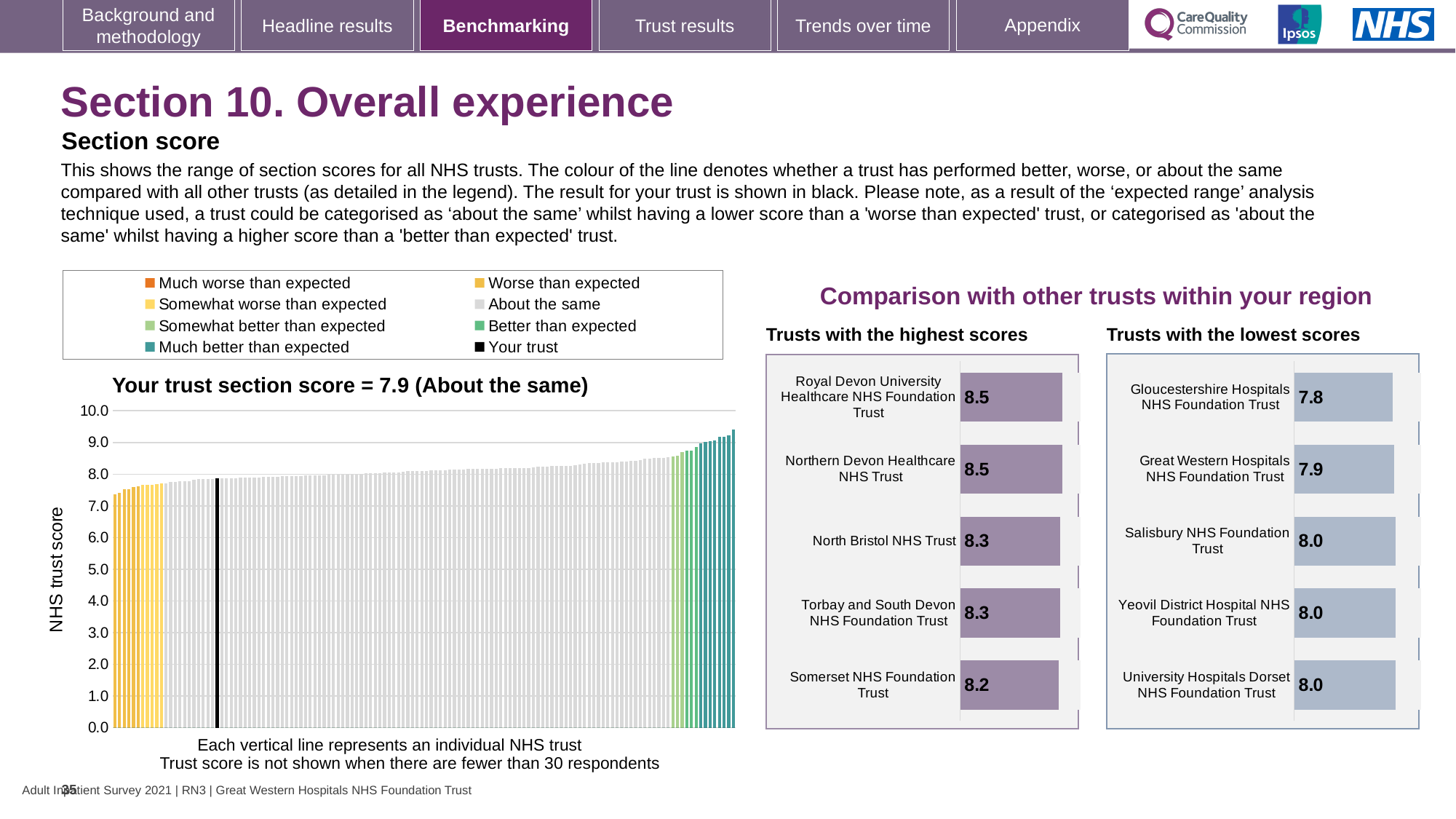
What kind of chart is the 'Your trust section score' chart? bar chart How many trusts are shown in the 'Trusts with the lowest scores' chart? 5 In the 'Your trust section score' chart, do the bars rise or fall from left to right? rise In the 'Trusts with the highest scores' chart, what is the difference between the scores of Royal Devon University Healthcare NHS Foundation Trust and Somerset NHS Foundation Trust? 0.3 In the 'Trusts with the highest scores' chart, which trust has the lowest score? Somerset NHS Foundation Trust In the 'Your trust section score' chart, is the value of the leftmost (lowest) bar greater or less than 8.0? less In the 'Your trust section score' chart, is the value of the rightmost (highest) bar greater or less than 9.0? greater In the 'Trusts with the highest scores' chart, what is the score for North Bristol NHS Trust? 8.3 In the 'Trusts with the lowest scores' chart, which trust has the lowest score? Gloucestershire Hospitals NHS Foundation Trust How many entries does the legend above the 'Your trust section score' chart list? 8 In the 'Trusts with the lowest scores' chart, which has the higher score: Great Western Hospitals NHS Foundation Trust or Gloucestershire Hospitals NHS Foundation Trust? Great Western Hospitals NHS Foundation Trust In the 'Your trust section score' chart, what is the section score for your trust? 7.9